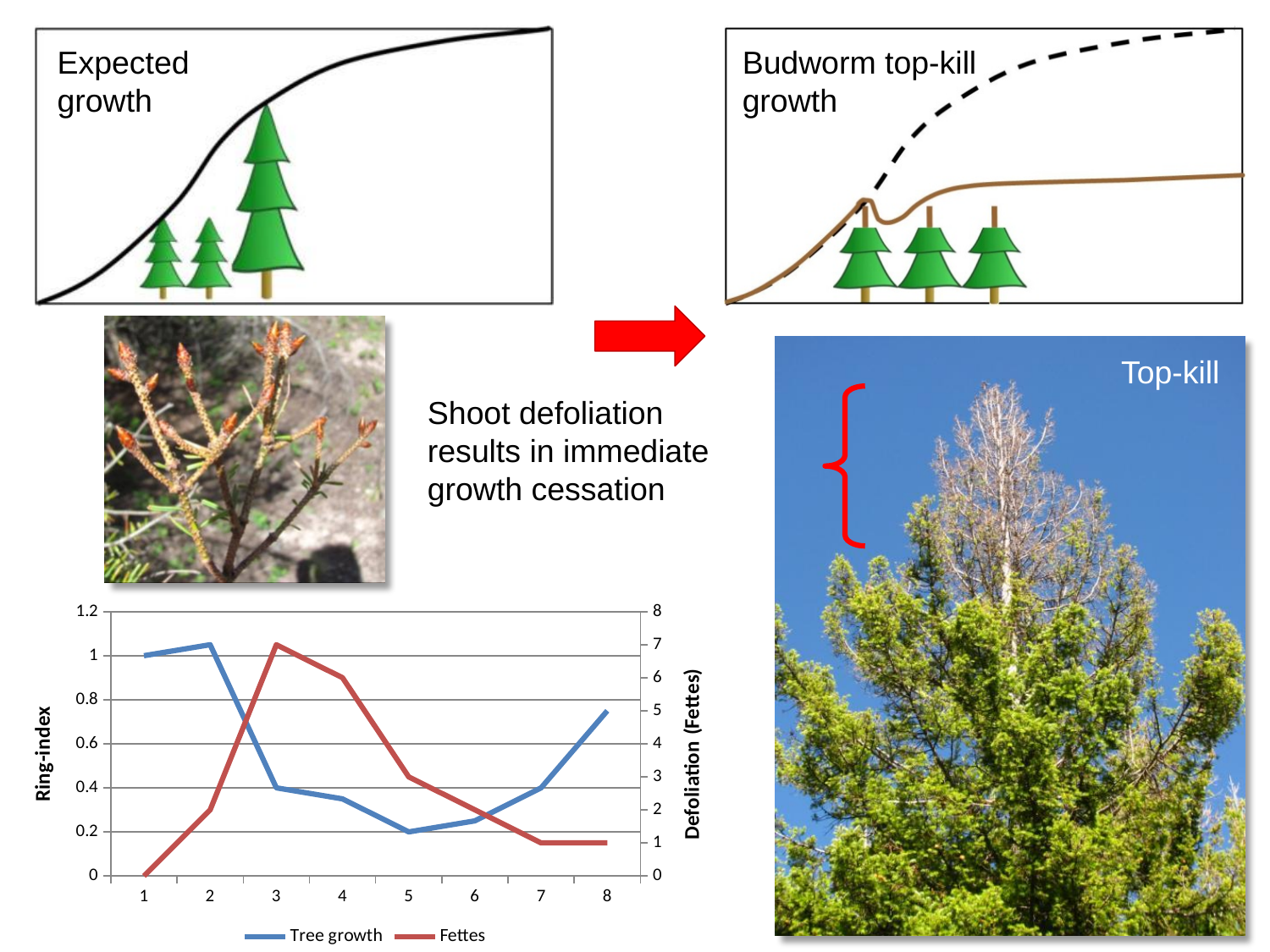
In the bottom-left line chart, what is the Tree growth value at x = 1? 1 In the bottom-left line chart, does the Fettes series rise or fall from x = 3 to x = 7? fall In the bottom-left line chart, is the Tree growth value at x = 8 greater or less than 0.6? greater What kind of chart is the chart at the bottom left of the slide? line chart In the bottom-left line chart, is the Fettes value at x = 5 greater or less than 4? less In the bottom-left line chart, is the Fettes value larger at x = 4 or at x = 6? x = 4 In the bottom-left line chart, how many points are plotted along the x axis for each series? 8 In the bottom-left line chart, at which x value does the Tree growth series reach its lowest point? 5 In the bottom-left line chart, at which x value does the Fettes series reach its highest point? 3 In the bottom-left line chart, how many series does the legend list? 2 In the bottom-left line chart, what is the Fettes value at x = 1? 0 In the bottom-left line chart, what is the Fettes value at x = 3? 7